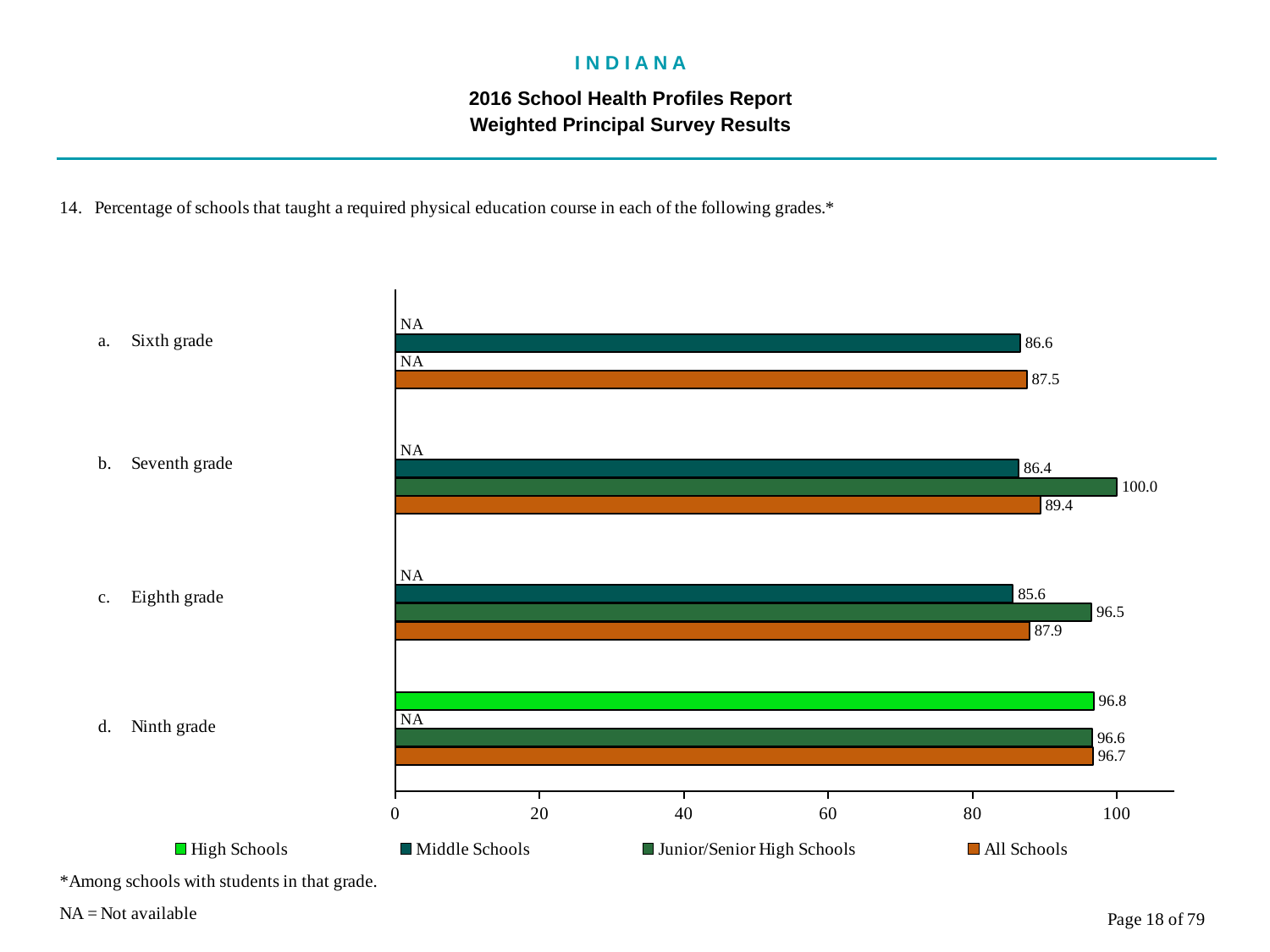
Which grade has the lowest value for Middle Schools? Eighth grade How many series does the legend list? 4 What is the difference between the Junior/Senior High Schools value and the All Schools value in Seventh grade? 10.6 Which is larger in Eighth grade: the Middle Schools value or the All Schools value? All Schools What kind of chart is shown on the slide? bar chart What is the value for High Schools in Ninth grade? 96.8 What is the value for Junior/Senior High Schools in Eighth grade? 96.5 What is the value for Middle Schools in Sixth grade? 86.6 Which grade has the highest value for All Schools? Ninth grade What is the value for All Schools in Seventh grade? 89.4 Is the value for Middle Schools in Seventh grade greater or less than 80? greater How many grade categories are shown on the chart? 4